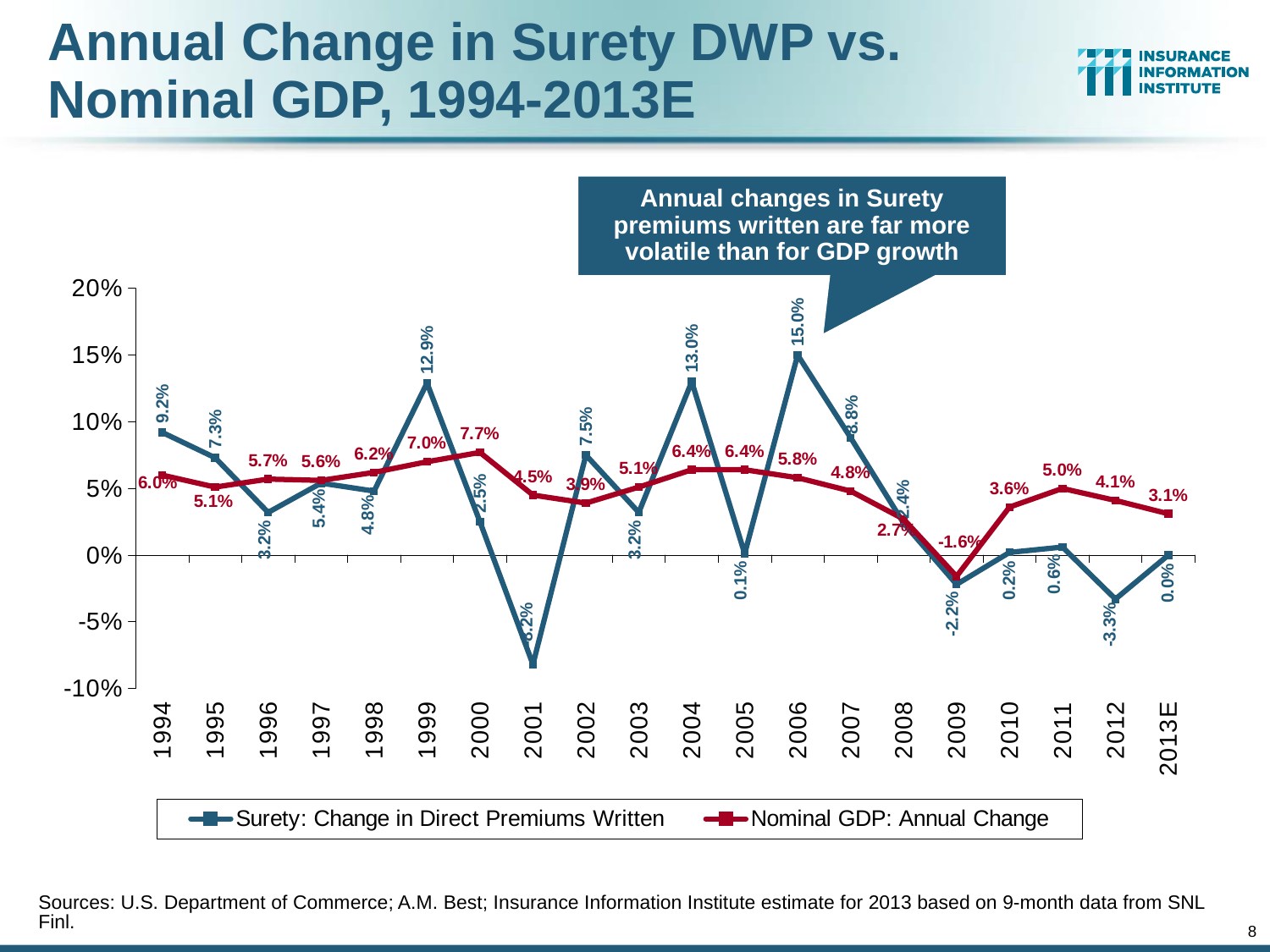
What is the Nominal GDP: Annual Change value for 2000? 7.7% In which year is Nominal GDP: Annual Change lowest? 2009 How many years are shown on the x axis? 20 What kind of chart is shown on the slide? Line chart In which year is Surety: Change in Direct Premiums Written highest? 2006 What is the Nominal GDP: Annual Change value for 2013E? 3.1% How many series does the legend list? 2 What is the Surety: Change in Direct Premiums Written value for 2012? -3.3% What is the difference between the Surety change and the Nominal GDP change in 2006? 9.2% What is the value of Surety: Change in Direct Premiums Written for 2006? 15.0% In 1999, which series has the larger value: Surety: Change in Direct Premiums Written or Nominal GDP: Annual Change? Surety: Change in Direct Premiums Written In which year is Nominal GDP: Annual Change highest? 2000